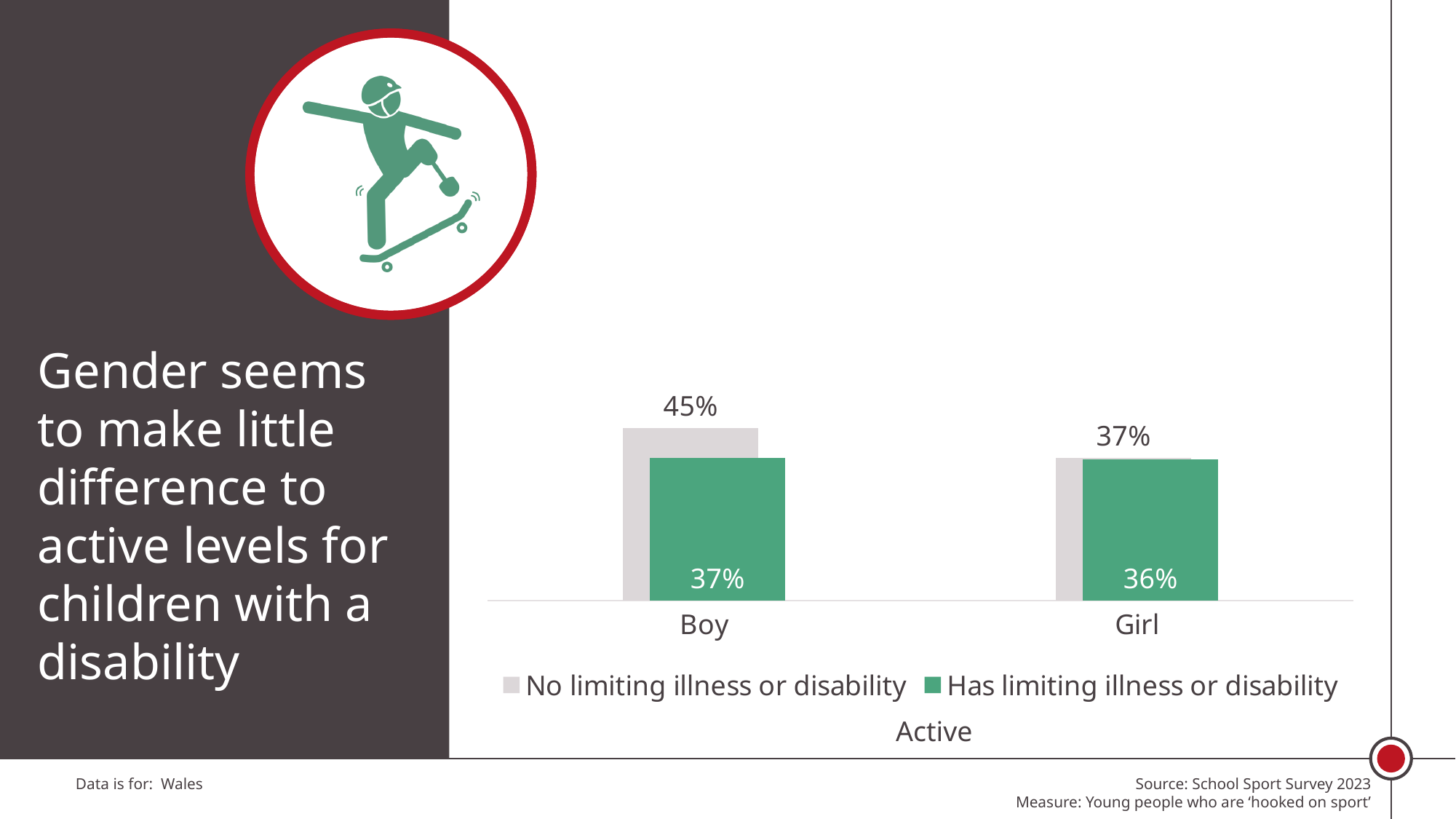
What is the difference between the 'No limiting illness or disability' and 'Has limiting illness or disability' values for Boy? 8% What is the value for Boy in the 'No limiting illness or disability' series? 45% For Boy, which series has the larger value: 'No limiting illness or disability' or 'Has limiting illness or disability'? No limiting illness or disability Which category has the highest value in the 'No limiting illness or disability' series? Boy What is the value for Girl in the 'Has limiting illness or disability' series? 36% What is the value for Boy in the 'Has limiting illness or disability' series? 37% What is the value for Girl in the 'No limiting illness or disability' series? 37% What is the title shown below the chart legend? Active How many series does the chart legend list? 2 How many categories are shown on the x axis of the chart? 2 What kind of chart is shown on the slide? Bar chart What is the difference between the 'No limiting illness or disability' values for Boy and Girl? 8%